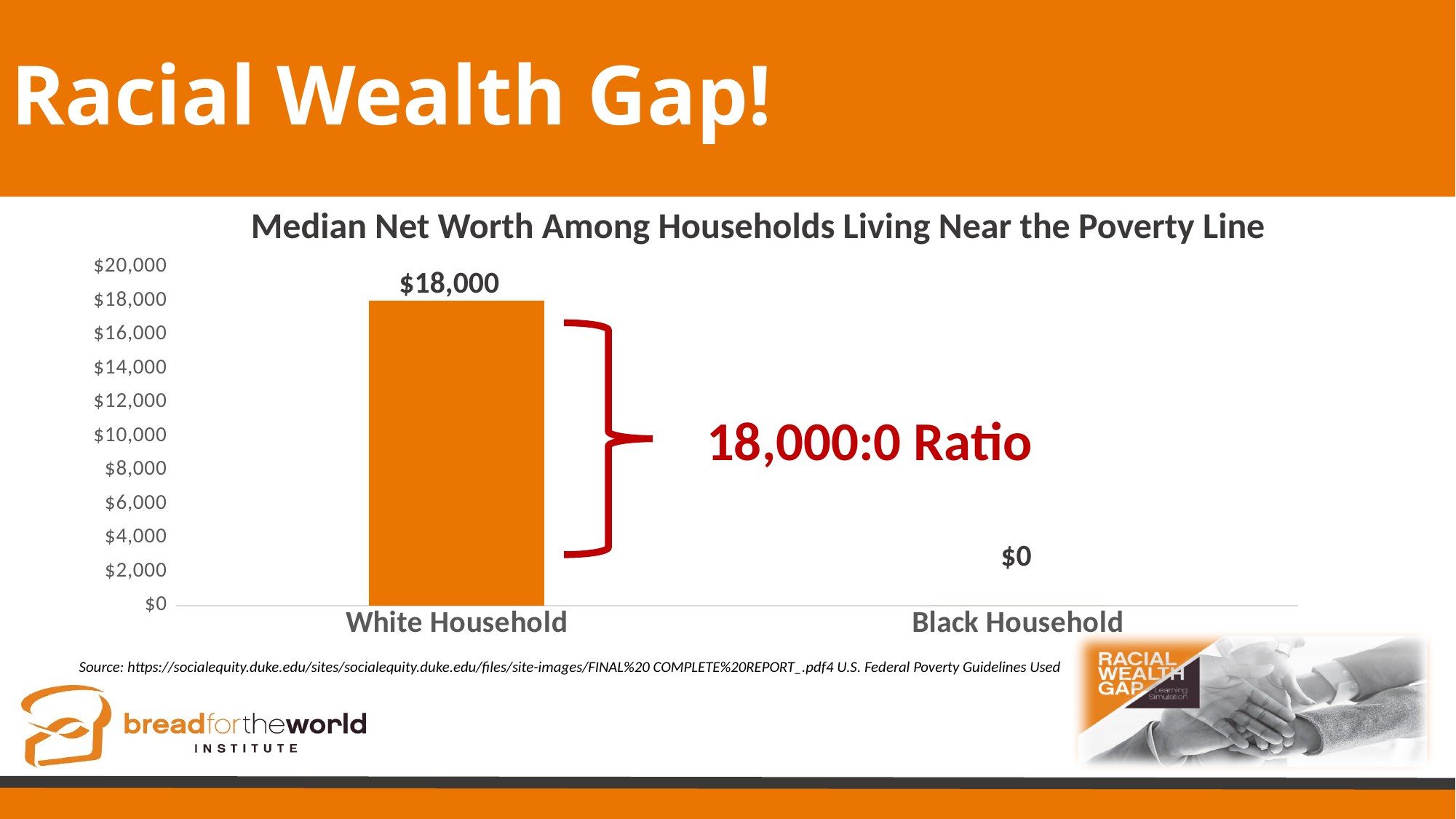
Which category has the highest median net worth? White Household How many categories are shown on the x axis? 2 Is the value for White Household greater or less than $10,000? greater What kind of chart is shown on the slide? bar chart Which is larger, the median net worth for White Household or for Black Household? White Household What is the difference between the median net worth of White Household and Black Household? $18,000 What is the median net worth shown for Black Household? $0 What is the title of the chart? Median Net Worth Among Households Living Near the Poverty Line What is the median net worth shown for White Household? $18,000 Which category has the lowest median net worth? Black Household What ratio is written in red next to the chart? 18,000:0 Ratio What is the highest value shown on the y axis? $20,000